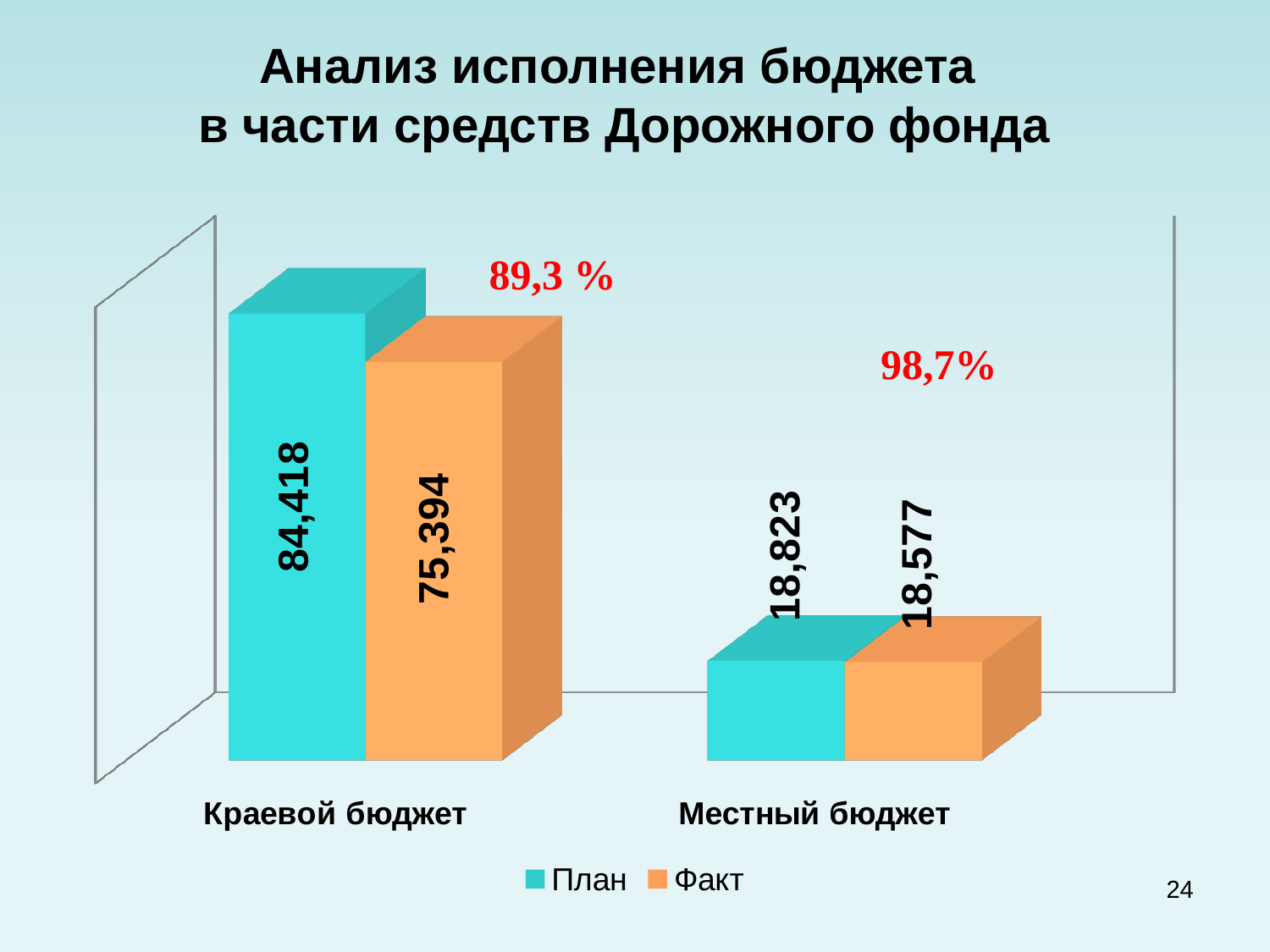
What is the Факт value for Местный бюджет? 18,577 What is the План value for Краевой бюджет? 84,418 Which is larger for Краевой бюджет, the План value or the Факт value? План What is the difference between the План and Факт values for Краевой бюджет? 9,024 How many categories are shown on the x axis? 2 What percentage is printed in red above the Местный бюджет bars? 98,7% How many series does the legend list? 2 What kind of chart is shown on the slide? Bar chart Which category has the lowest Факт value? Местный бюджет What is the Факт value for Краевой бюджет? 75,394 Which category has the highest План value? Краевой бюджет What is the План value for Местный бюджет? 18,823